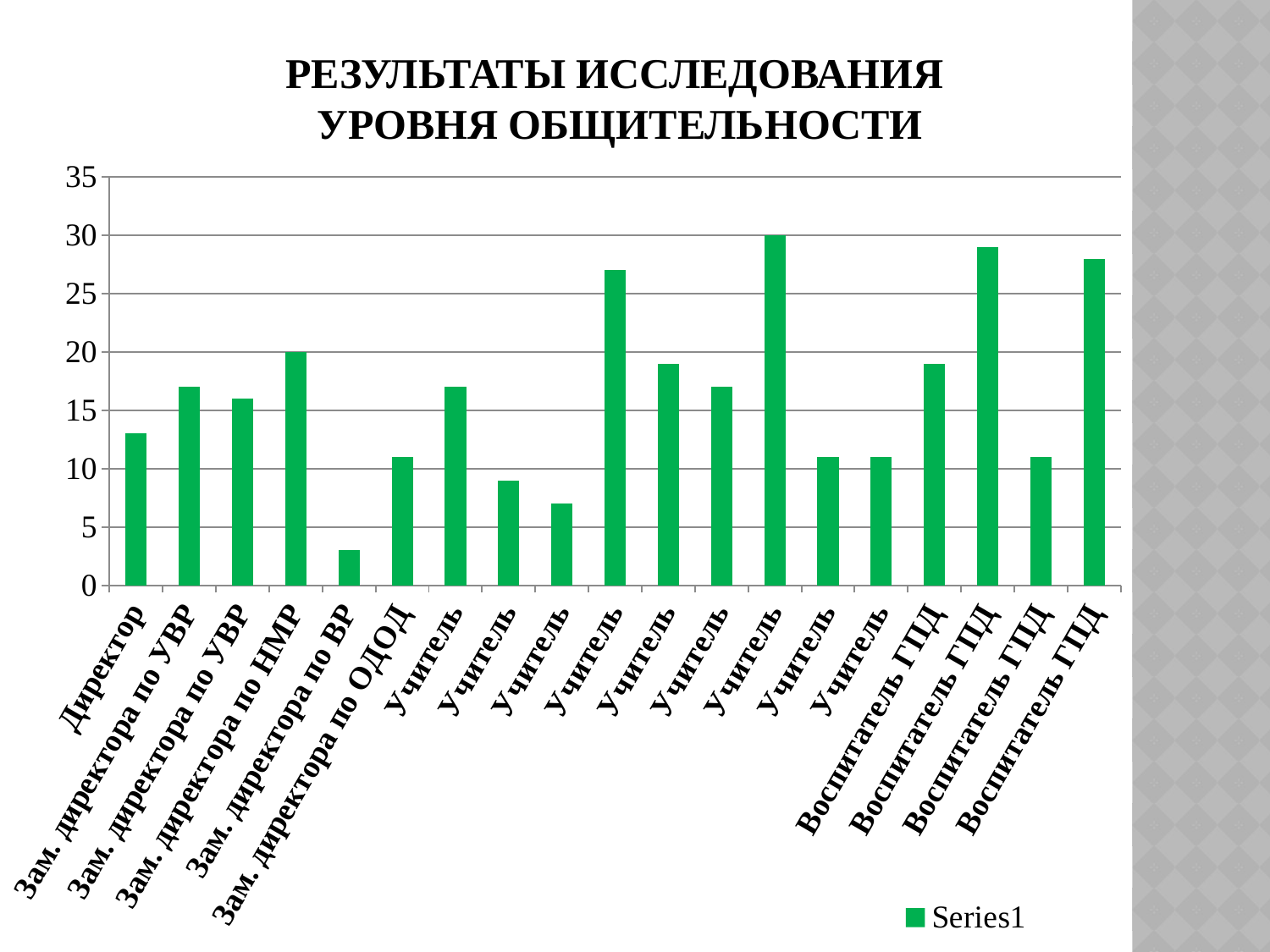
What type of chart is shown on the slide? bar chart How many bars are plotted in the chart? 19 Is the value for Зам. директора по ВР greater or less than 5? less Which is larger, the value for Директор or the value for Зам. директора по НМР? Зам. директора по НМР Is the value for Зам. директора по ОДОД greater or less than 10? greater What colour are the bars in the chart? green What is the value for Зам. директора по НМР? 20 How many series does the legend list? 1 What is the name of the series shown in the legend? Series1 Which is larger, the value for Зам. директора по ВР or the value for Директор? Директор Is the value for Директор greater or less than 15? less Which category has the lowest value? Зам. директора по ВР